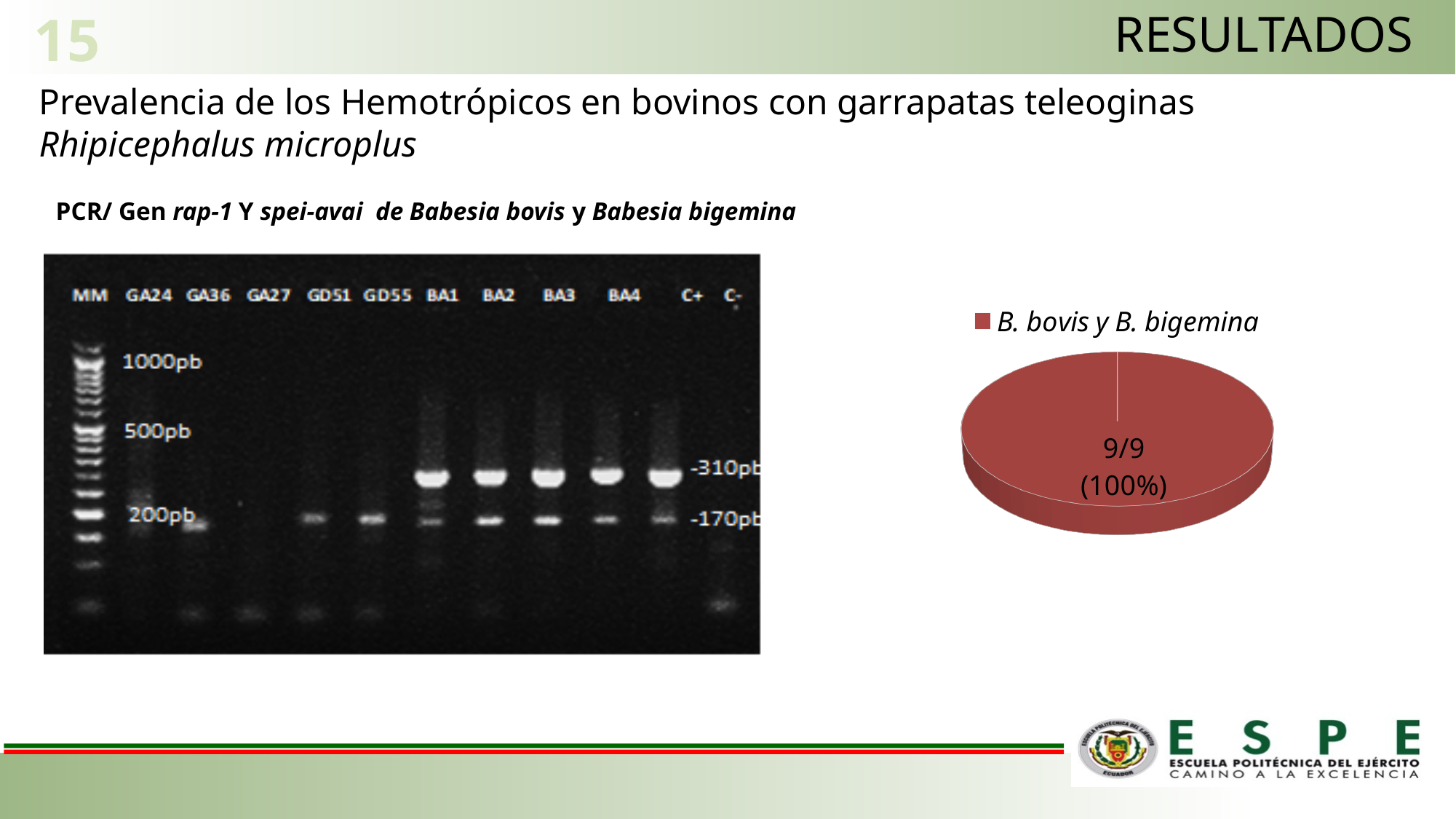
How many slices does the pie chart have? 1 What colour is the slice of the pie chart? red What is the legend entry of the pie chart? B. bovis y B. bigemina How many entries does the legend of the pie chart list? 1 What data label is shown on the pie chart slice? 9/9 (100%) What kind of chart is shown on the right side of the slide? pie chart What share of the pie does the B. bovis y B. bigemina slice represent? 100%